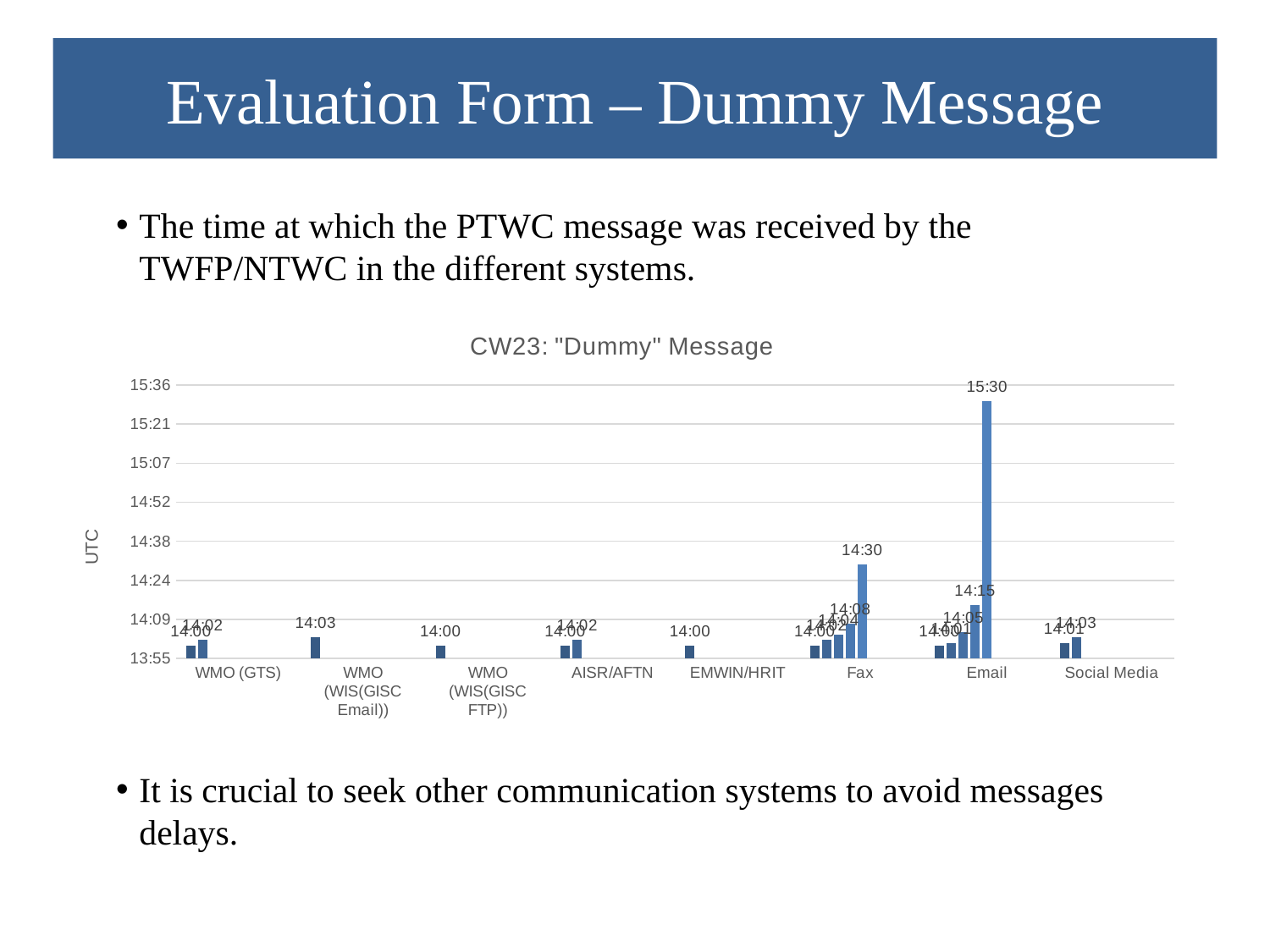
Which category contains the highest (latest) time value in the chart? Email What time value is shown for EMWIN/HRIT? 14:00 What kind of chart is shown on the slide? bar chart What is the latest time value shown for Email? 15:30 What is the label on the vertical axis of the chart? UTC What is the latest time value shown for Fax? 14:30 What is the title of the chart? CW23: "Dummy" Message How many communication system categories are shown on the x axis? 8 Is the tallest bar for Fax greater or less than 14:38? less How many minutes later is the latest Email time (15:30) than the latest Fax time (14:30)? 60 minutes Which has the later maximum time value, Fax or Email? Email What time value is shown for WMO (WIS(GISC Email))? 14:03